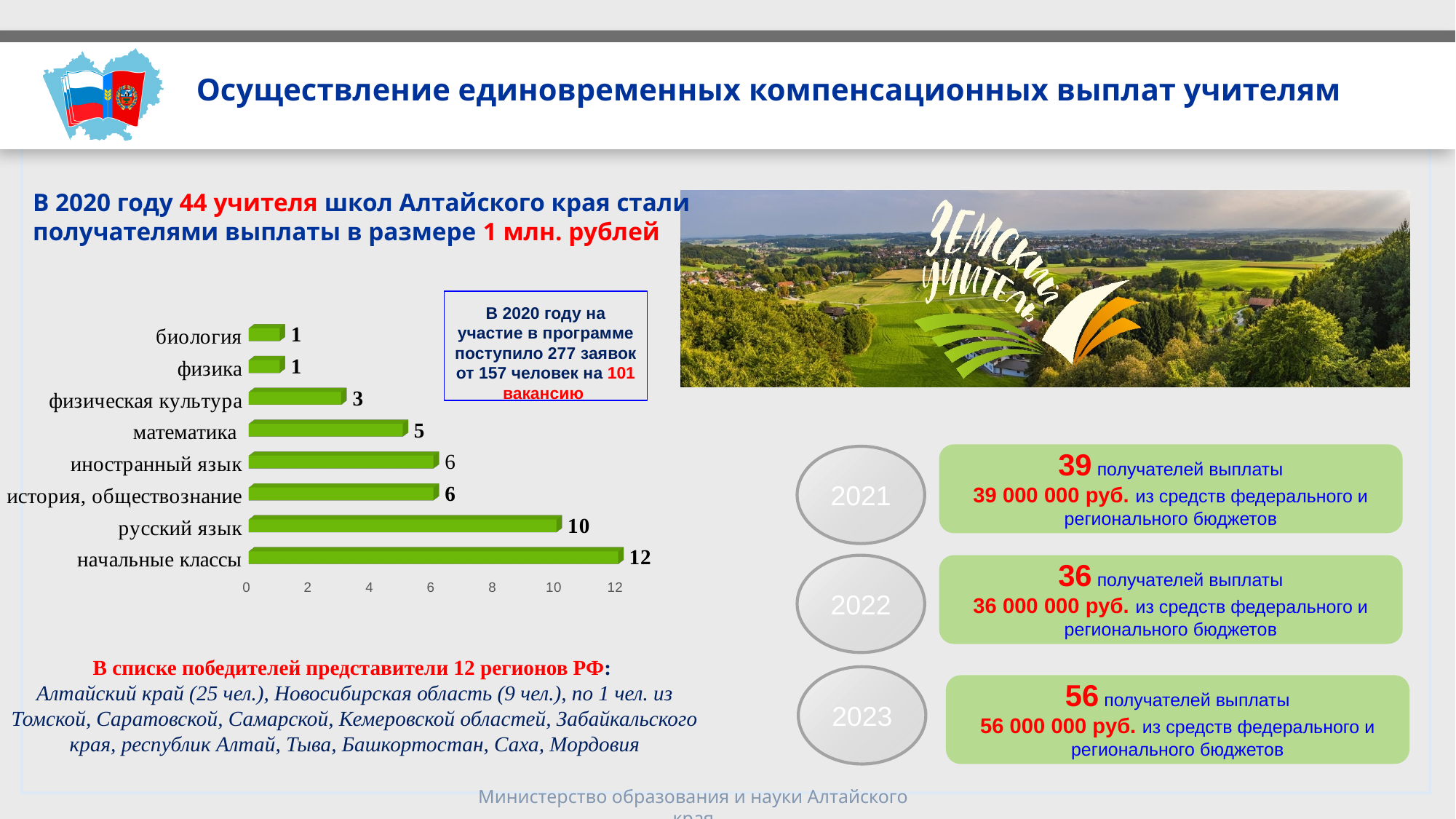
What value is shown for начальные классы in the bar chart? 12 How many categories are shown in the bar chart? 8 What kind of chart is shown on the slide? bar chart What is the difference between the values for иностранный язык and физическая культура? 3 Is the value for русский язык greater or less than 8? greater What value is shown for русский язык in the bar chart? 10 What is the difference between the values for начальные классы and русский язык? 2 What is the maximum value shown on the horizontal axis of the bar chart? 12 What value is shown for физическая культура in the bar chart? 3 Which category has the highest value in the bar chart? начальные классы What value is shown for математика in the bar chart? 5 Which is larger in the bar chart: the value for математика or the value for история, обществознание? история, обществознание